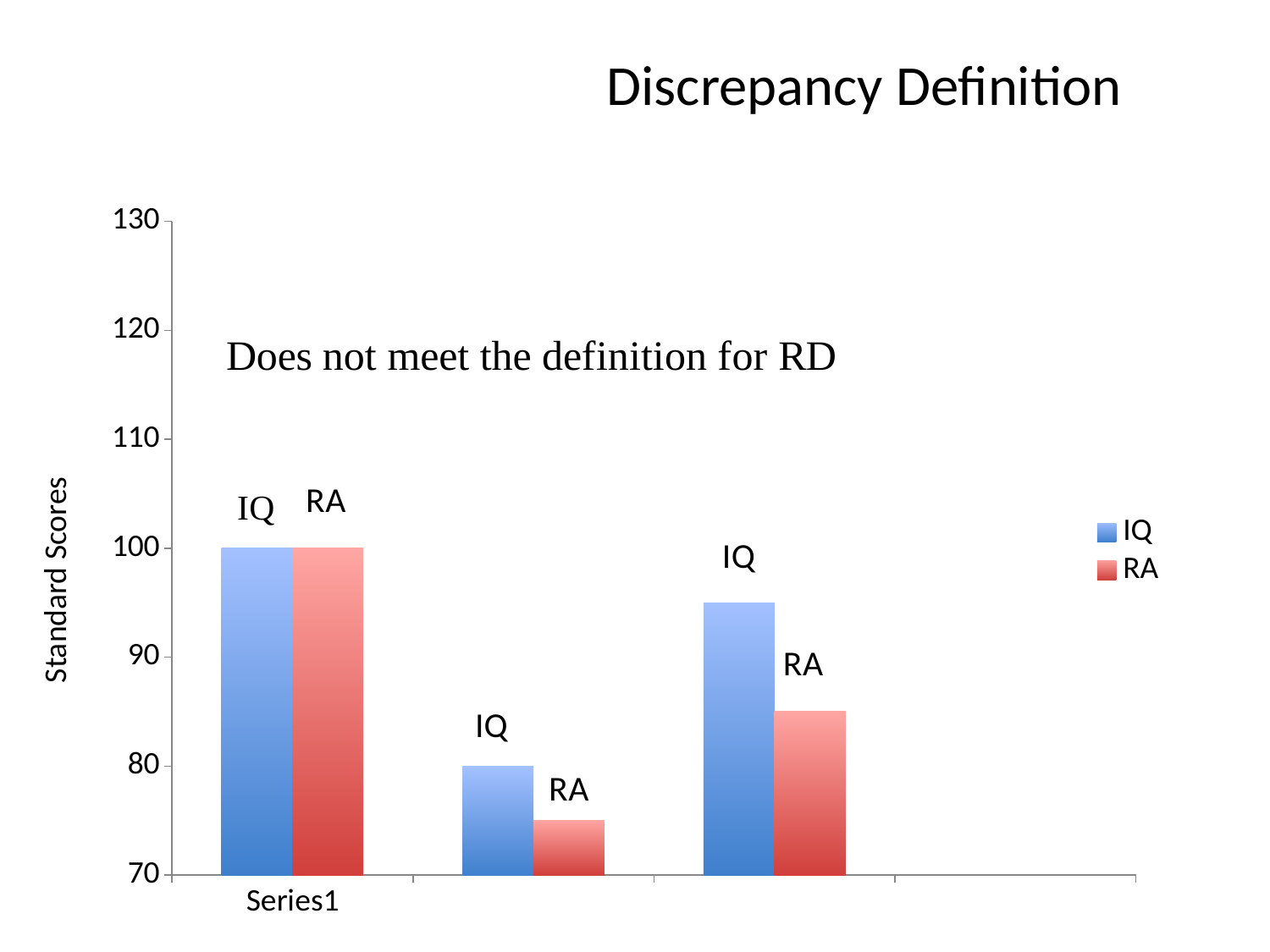
How many series does the legend list? 2 Which group of bars has the lowest RA value? The middle group Is the IQ value for the rightmost group of bars greater or less than 90? greater Which group of bars has the highest IQ value? Series1 What is the IQ value for Series1? 100 Is the IQ value for the middle group of bars greater or less than 90? less What is the title of the chart? Discrepancy Definition Is the RA value for the middle group of bars greater or less than 80? less What is the title of the y axis? Standard Scores How many groups of bars are plotted in the chart? 3 What kind of chart is shown on the slide? Bar chart What is the RA value for Series1? 100